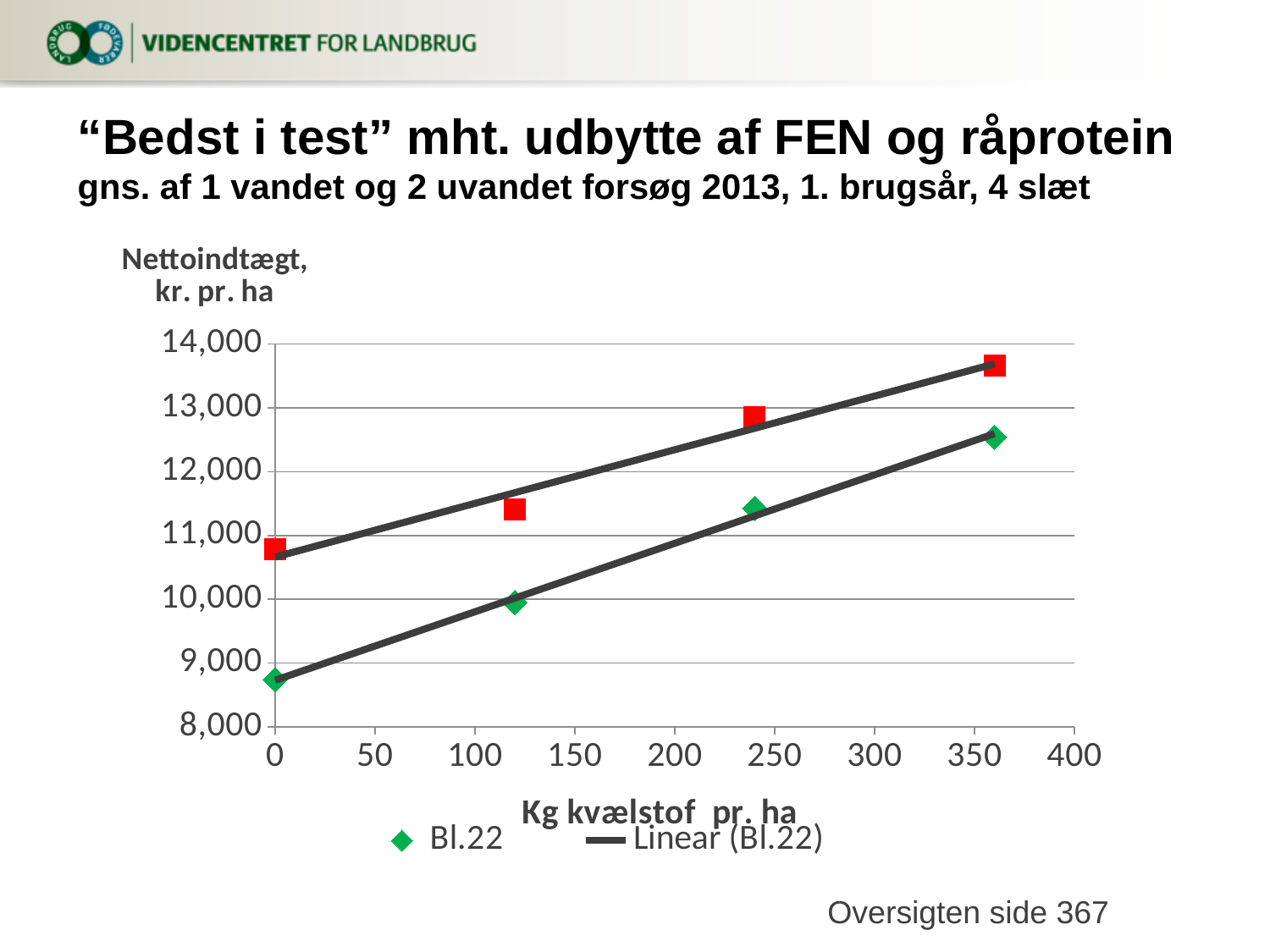
What kind of chart is shown on the slide? scatter chart Is the Bl.22 value at 0 kg kvælstof pr. ha greater or less than 9,000? less Is the Bl.22 value at 360 kg kvælstof pr. ha greater or less than 12,000? greater Is the Bl.22 value at 240 kg kvælstof pr. ha greater or less than 11,000? greater Does the net income for Bl.22 rise or fall as kg kvælstof pr. ha increases? rise How many entries does the chart legend list? 2 Which is larger for Bl.22: the value at 120 kg kvælstof pr. ha or the value at 240 kg kvælstof pr. ha? 240 kg kvælstof pr. ha At which kg kvælstof pr. ha level does the Bl.22 series have its lowest net income? 0 How many data points are plotted for the Bl.22 series? 4 At which kg kvælstof pr. ha level does the Bl.22 series reach its highest net income? 360 What is the title of the horizontal axis? Kg kvælstof pr. ha What is the title of the vertical axis? Nettoindtægt, kr. pr. ha